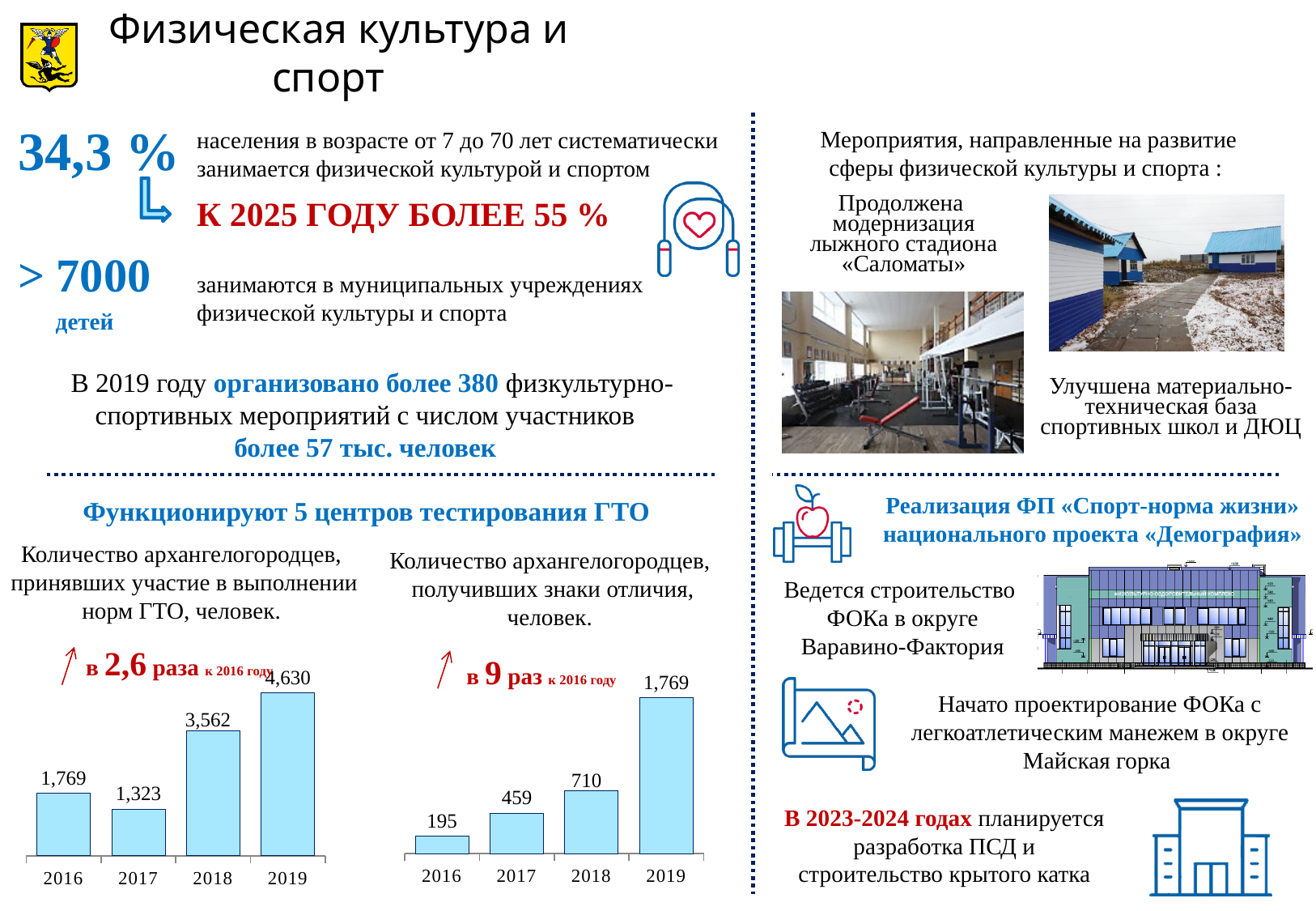
In the left chart (participants in GTO norms), which is larger, the value for 2016 or 2017? 2016 In the right chart (recipients of distinction badges), what is the value for 2018? 710 In the right chart (recipients of distinction badges), what is the difference between the 2019 and 2016 values? 1,574 How many years are shown on the x axis of the right chart (recipients of distinction badges)? 4 In the right chart (recipients of distinction badges), what is the value for 2016? 195 In the right chart (recipients of distinction badges), do the values rise or fall from 2016 to 2019? rise In the left chart (participants in GTO norms), which year has the lowest value? 2017 In the left chart (participants in GTO norms), which year has the highest value? 2019 In the left chart (participants in GTO norms), what is the value for 2017? 1,323 In the left chart (participants in GTO norms), what is the difference between the 2019 and 2018 values? 1,068 In the left chart (participants in GTO norms), what is the value for 2019? 4,630 What type of chart is the left chart (participants in GTO norms)? bar chart